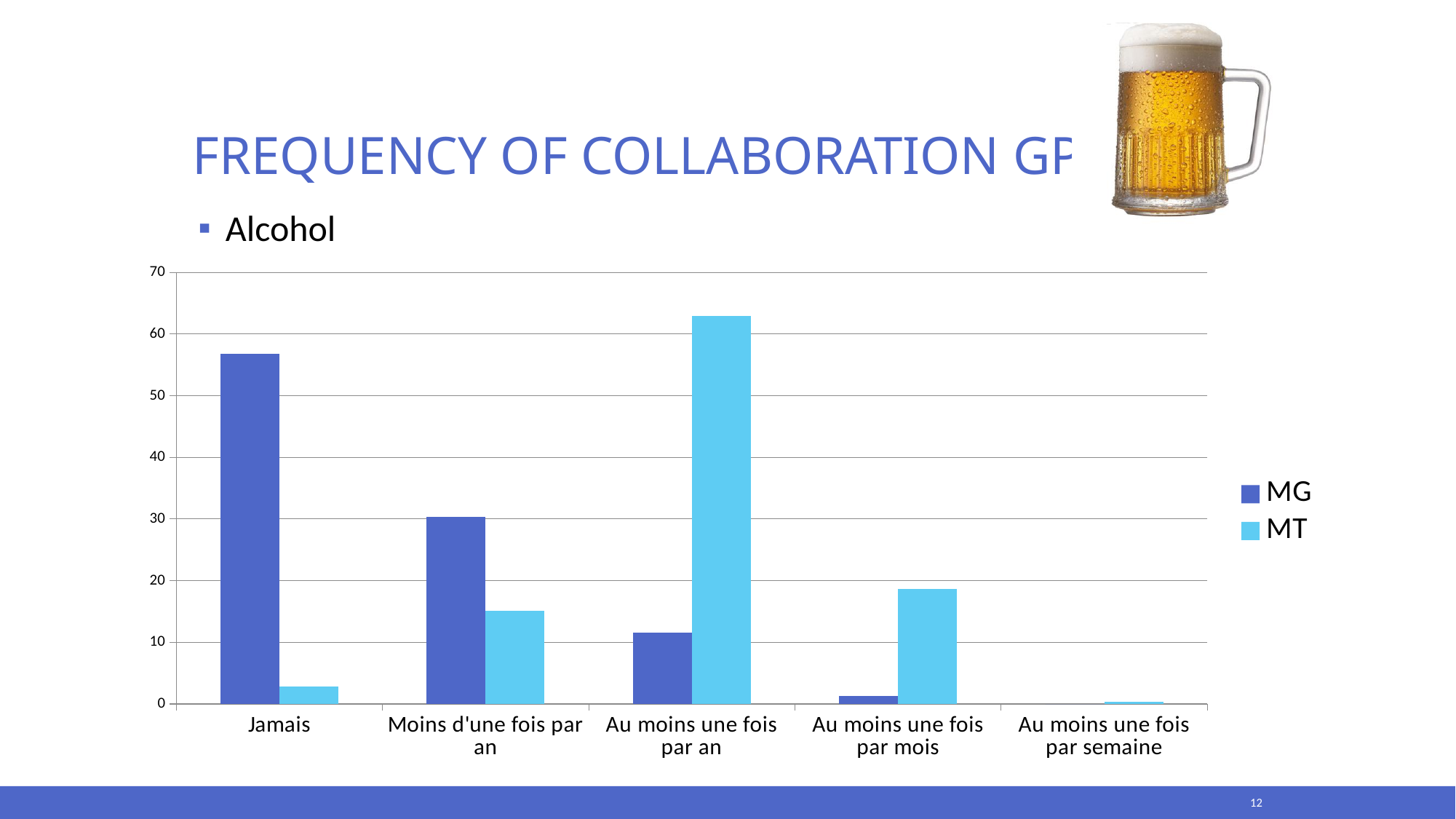
What kind of chart is shown on the slide? bar chart Is the MG value for Jamais greater or less than 50? greater What are the two series named in the legend? MG and MT Which category has the lowest MG value? Au moins une fois par semaine Which category has the highest MG value? Jamais For Moins d'une fois par an, which series has the larger value, MG or MT? MG How many series does the legend list? 2 Is the MT value for Moins d'une fois par an greater or less than 20? less For Au moins une fois par mois, which series has the larger value, MG or MT? MT Which category has the highest MT value? Au moins une fois par an How many categories are shown on the x axis? 5 Is the MT value for Au moins une fois par an greater or less than 60? greater